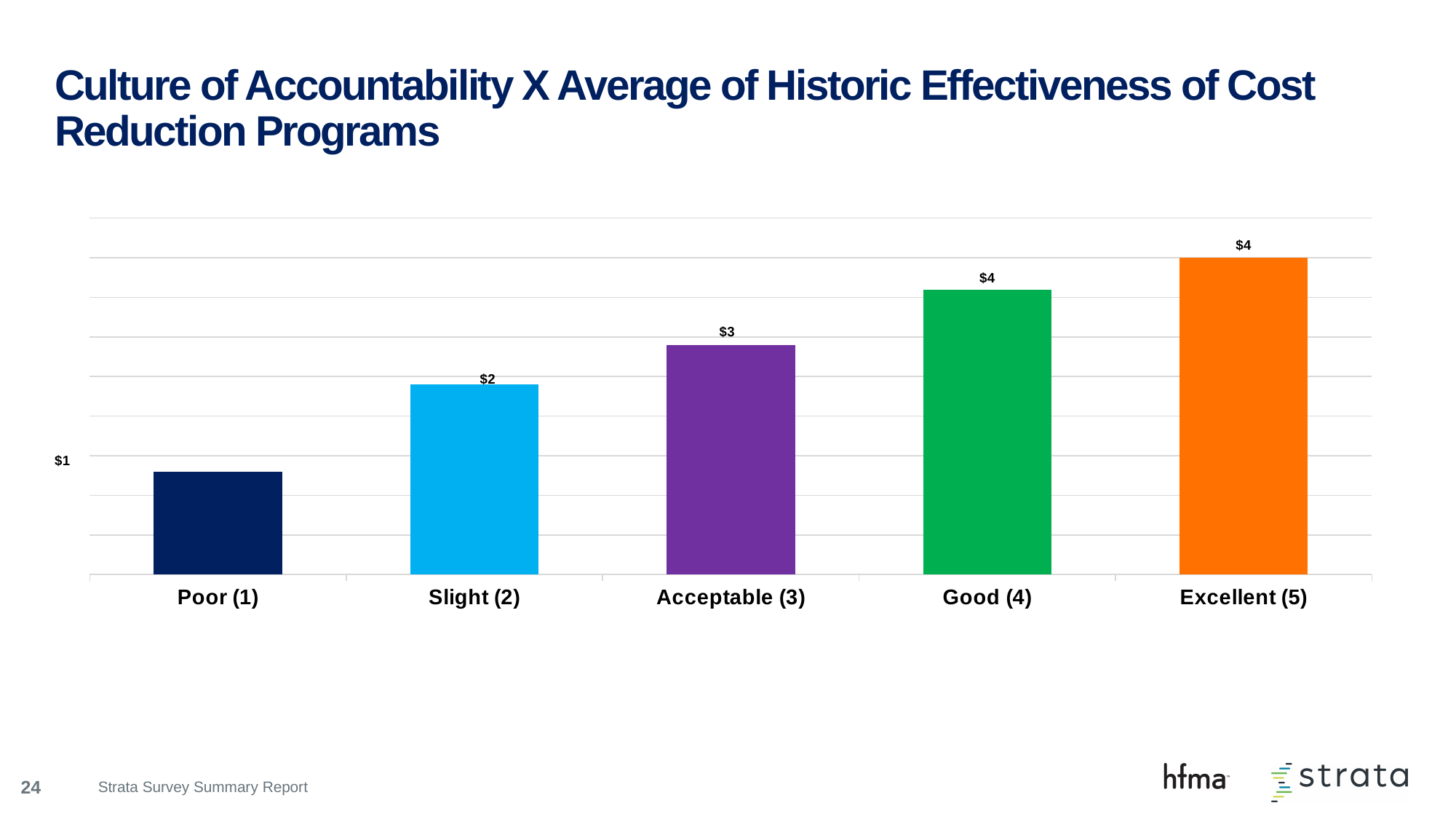
What kind of chart is shown on the slide? Bar chart How many categories are shown on the x axis? 5 What is the difference between the values for Acceptable (3) and Poor (1)? $2 Which category has the tallest bar? Excellent (5) What is the value shown for Poor (1)? $1 What is the value shown for Good (4)? $4 Which category has the lowest value? Poor (1) What is the value shown for Acceptable (3)? $3 What colour is the bar for Excellent (5)? Orange Which is larger, the value for Slight (2) or the value for Acceptable (3)? Acceptable (3) What is the value shown for Slight (2)? $2 Do the values rise or fall from Poor (1) to Excellent (5)? Rise